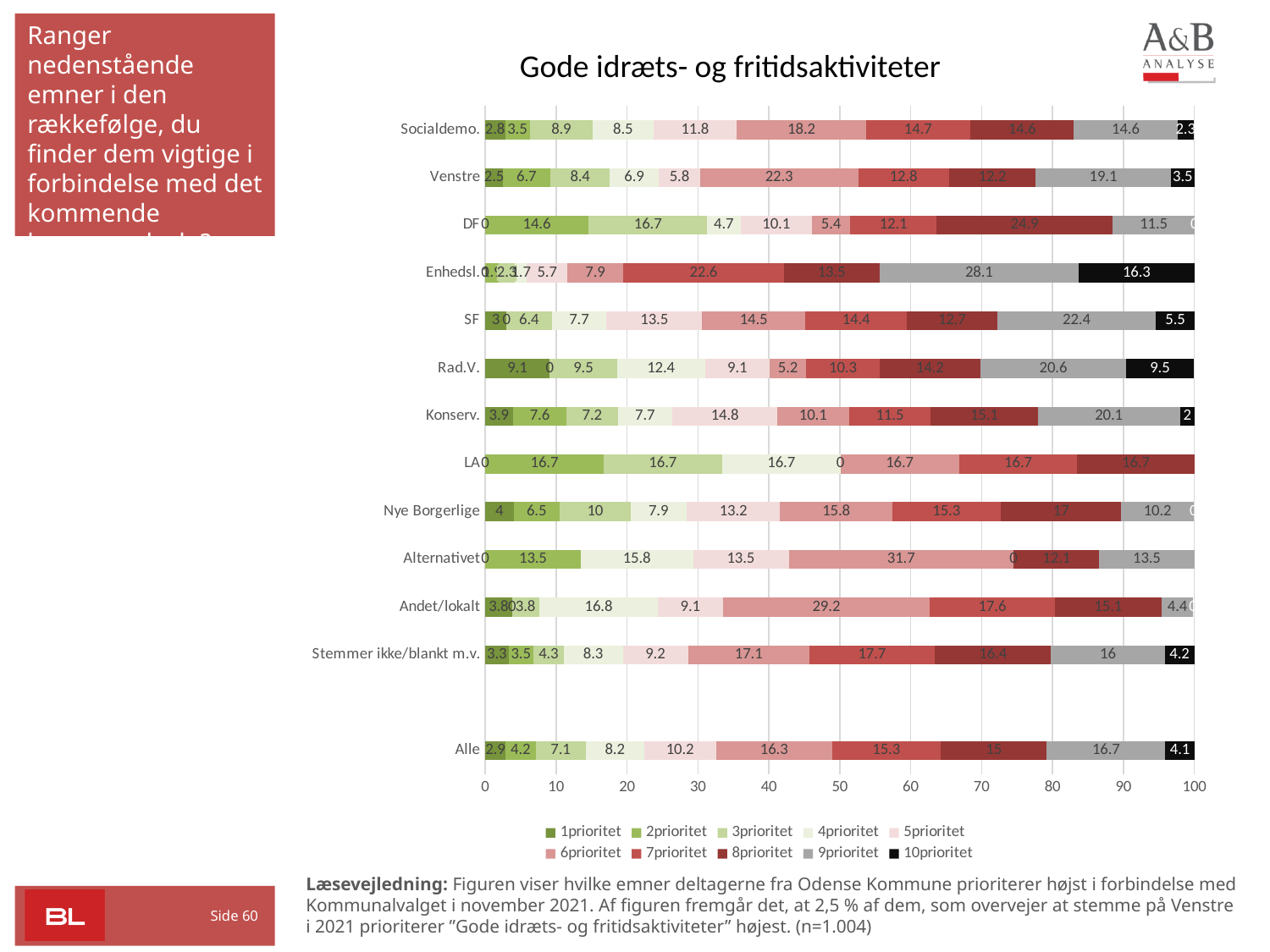
For Alle, what is the difference between the 9prioritet value and the 10prioritet value? 12.6 What kind of chart is shown on the slide? Stacked bar chart What is the value of the 10prioritet segment for Alle? 4.1 What is the title of the chart? Gode idræts- og fritidsaktiviteter How many categories (rows) are plotted on the y axis? 13 How many series does the legend list? 10 Which category has the largest 9prioritet segment? Enhedsl. What is the value of the 9prioritet segment for Enhedsl.? 28.1 What is the value of the 6prioritet segment for Venstre? 22.3 Which has the larger 6prioritet value, Socialdemo. or Venstre? Venstre What is the value of the 5prioritet segment for Alternativet? 13.5 What is the value of the 8prioritet segment for DF? 24.9